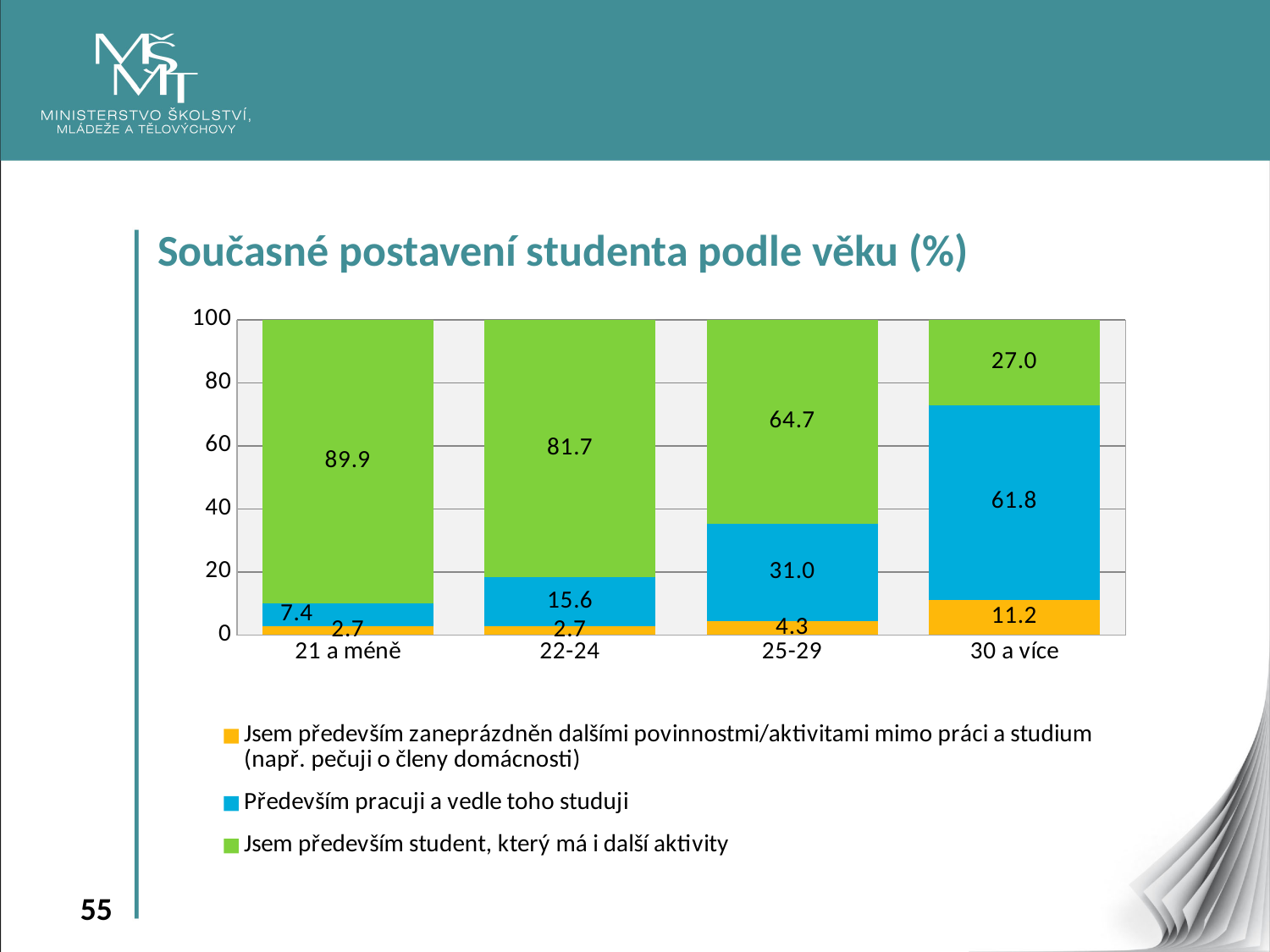
What is the value for 'Především pracuji a vedle toho studuji' in the '30 a více' age group? 61.8 How many series does the legend list? 3 What type of chart is shown on the slide? stacked bar chart Does the value for 'Především pracuji a vedle toho studuji' rise or fall as age increases along the x axis? rise Which age group has the highest value for 'Především pracuji a vedle toho studuji'? 30 a více What is the value for 'Jsem především student, který má i další aktivity' in the '21 a méně' age group? 89.9 Which is larger: the 'Jsem především student, který má i další aktivity' value for '22-24' or for '25-29'? 22-24 What is the value for 'Jsem především zaneprázdněn dalšími povinnostmi/aktivitami mimo práci a studium' in the '25-29' age group? 4.3 Which age group has the lowest value for 'Jsem především student, který má i další aktivity'? 30 a více How many age groups are shown on the x axis? 4 What is the difference between the 'Především pracuji a vedle toho studuji' values for '25-29' and '22-24'? 15.4 What is the total of the stacked bar for the '22-24' age group? 100.0